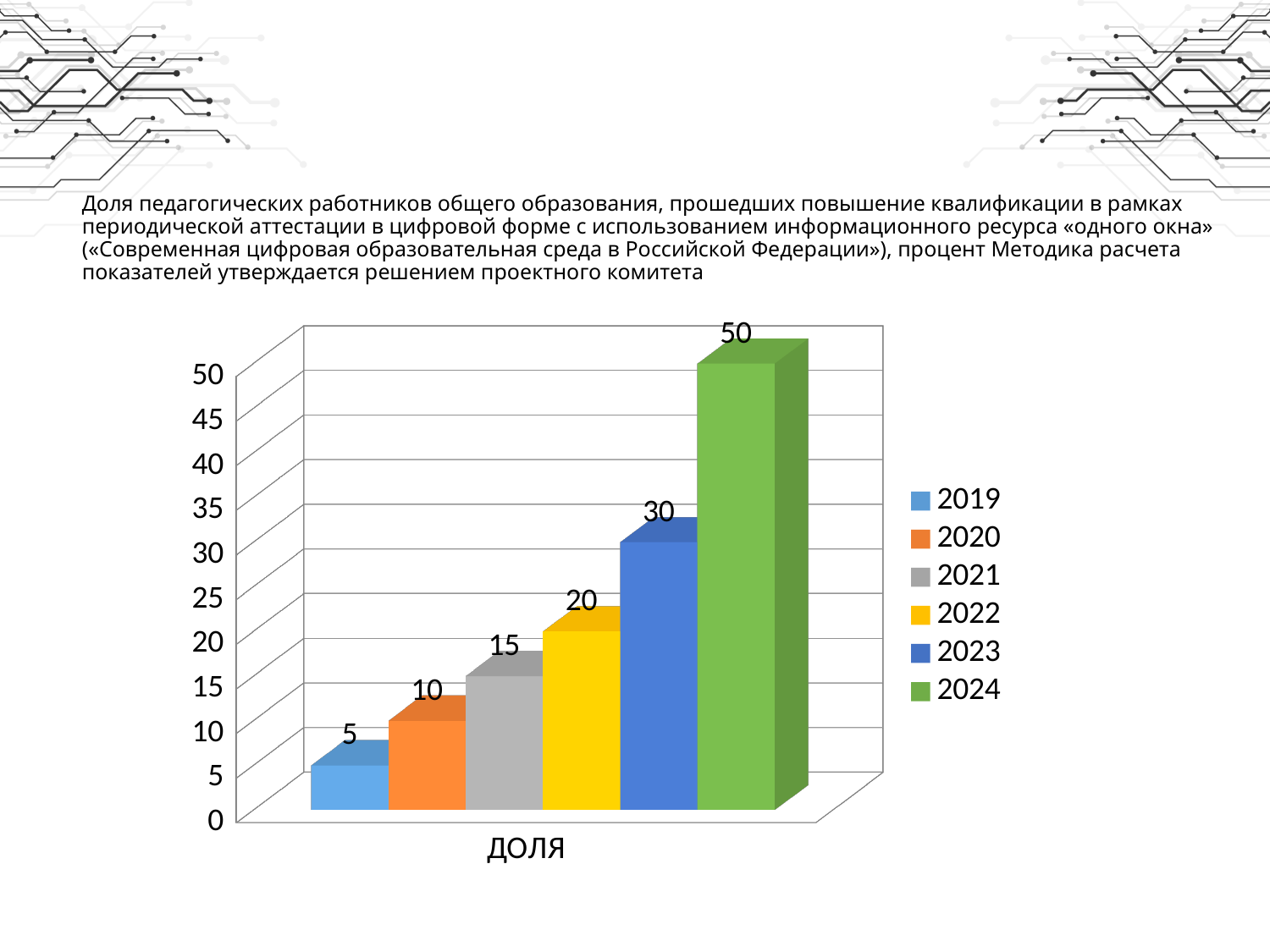
Do the values rise or fall from 2019 to 2024? rise What is the difference between the values for 2024 and 2023? 20 How many series does the legend list? 6 What is the value for 2024? 50 Which is larger, the value for 2022 or the value for 2023? 2023 Which year has the highest value? 2024 What is the label on the x axis of the chart? ДОЛЯ What is the difference between the values for 2021 and 2020? 5 What is the value for 2019? 5 What is the value for 2022? 20 What kind of chart is shown? bar chart Which year has the lowest value? 2019